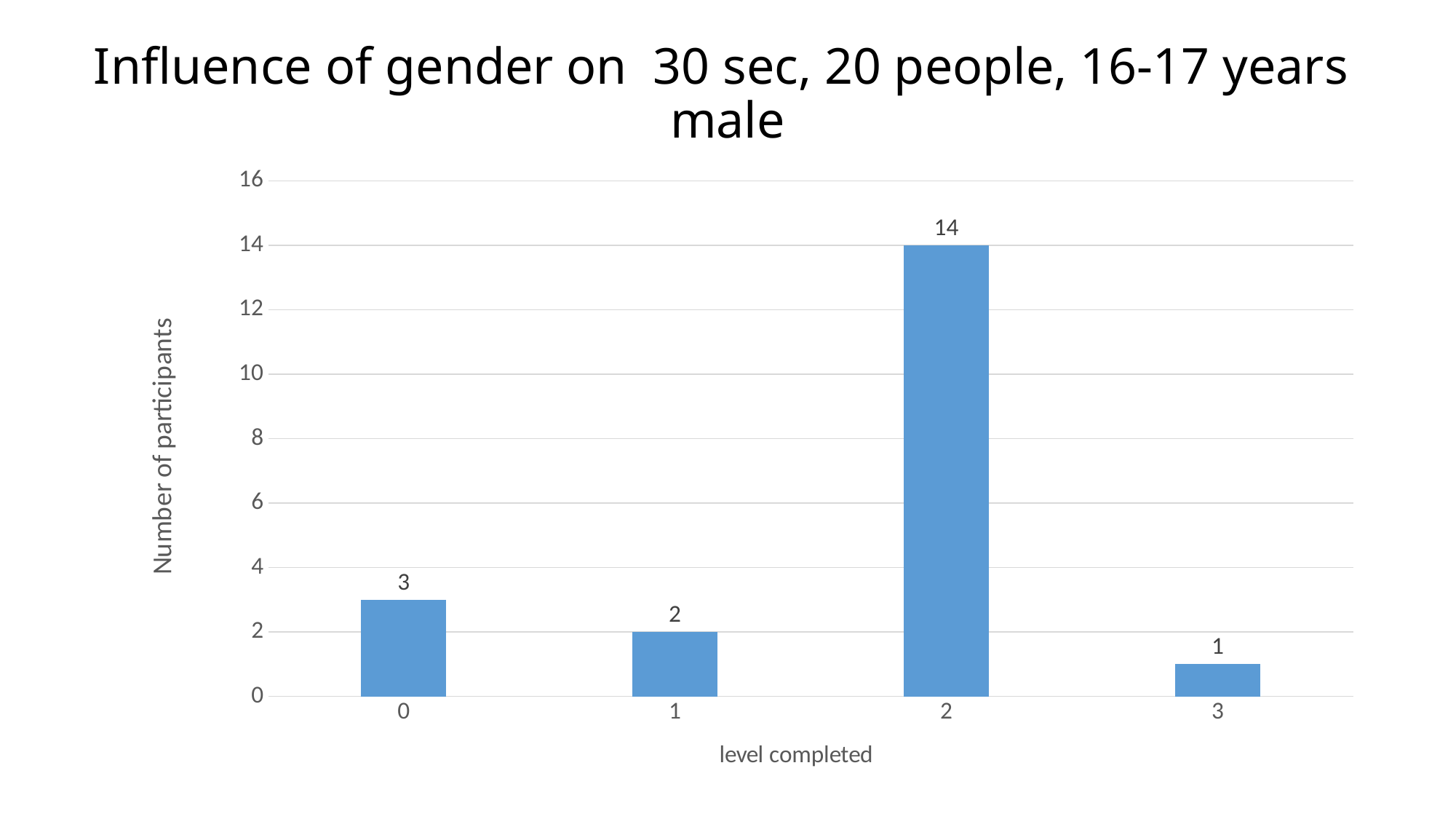
What kind of chart is shown on the slide? bar chart Which level completed has the lowest number of participants? 3 How many participants completed level 2? 14 How many level categories are shown on the x axis? 4 Is the number of participants for level 2 greater or less than 10? greater What is the label of the x axis? level completed How many participants completed level 3? 1 How many participants completed level 0? 3 What is the difference in number of participants between level 2 and level 0? 11 Which level completed has the highest number of participants? 2 What is the label of the y axis? Number of participants Which has more participants, level 0 or level 1? level 0